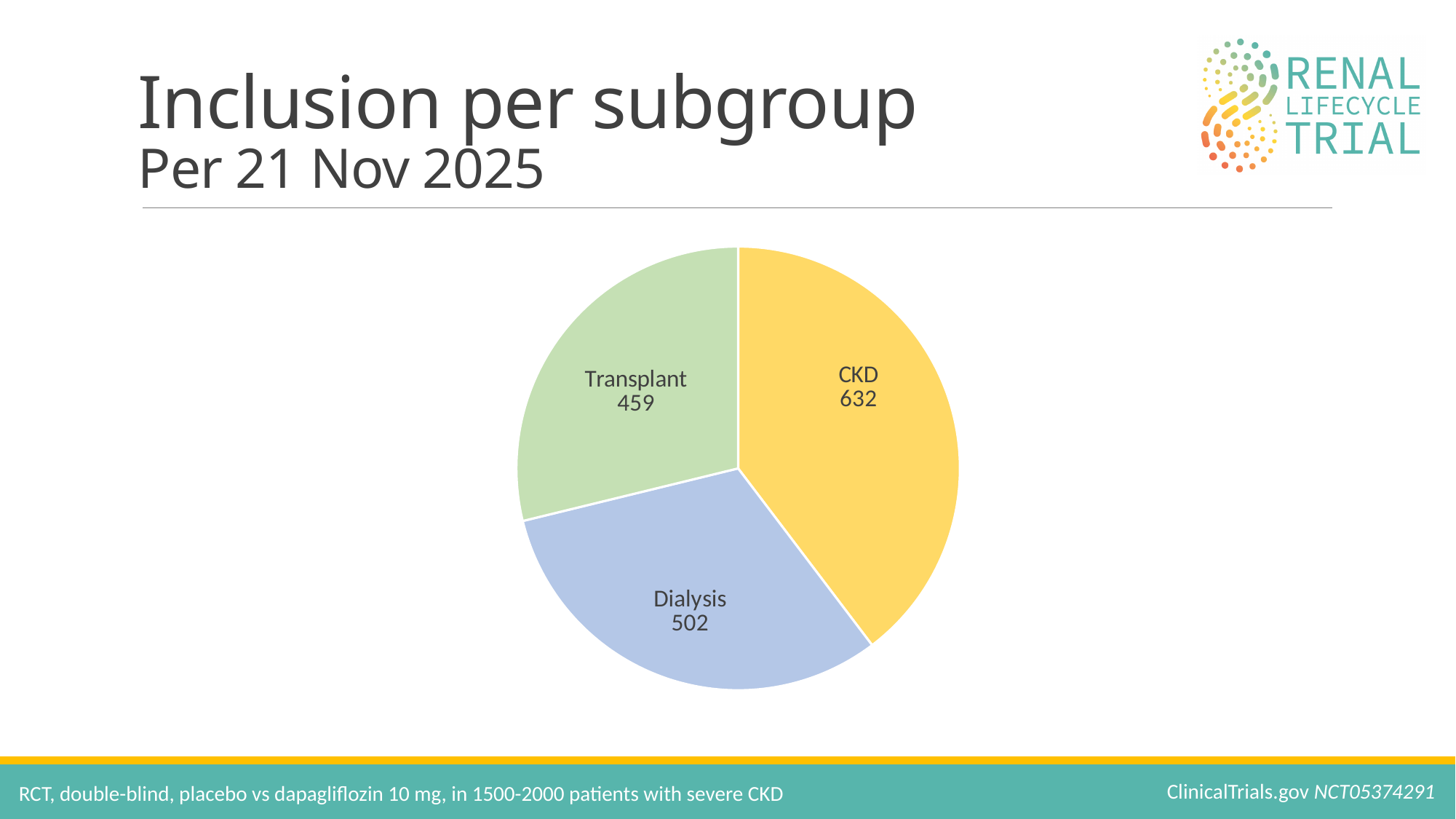
Which subgroup has the largest number of included patients? CKD What is the total number of included patients across all three subgroups? 1593 Which subgroup has more included patients, Dialysis or Transplant? Dialysis What type of chart is shown on the slide? pie chart What is the difference between the Dialysis and Transplant inclusion numbers? 43 What is the difference between the CKD and Transplant inclusion numbers? 173 How many patients are included in the CKD subgroup? 632 Which colour represents the Dialysis slice in the pie chart? blue How many slices does the pie chart have? 3 How many patients are included in the Transplant subgroup? 459 How many patients are included in the Dialysis subgroup? 502 Which subgroup has the smallest number of included patients? Transplant